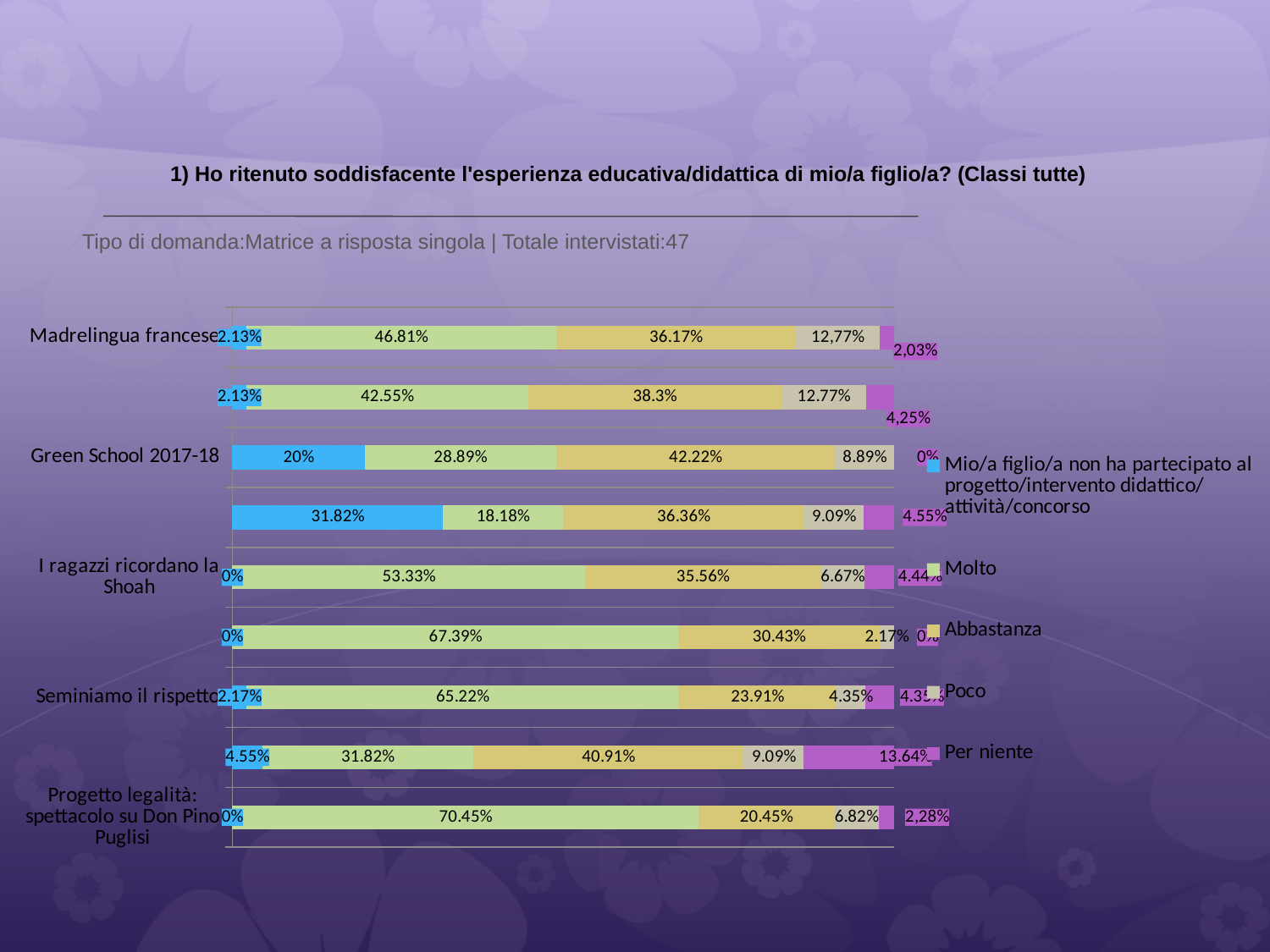
Which is larger, the 'Abbastanza' value for Madrelingua francese or for Seminiamo il rispetto? Madrelingua francese What is the 'Molto' value for Progetto legalità: spettacolo su Don Pino Puglisi? 70.45% How many series does the legend list? 5 What is the 'Molto' value for Madrelingua francese? 46.81% Which category has the highest 'Molto' value? Progetto legalità: spettacolo su Don Pino Puglisi What is the value for 'Mio/a figlio/a non ha partecipato al progetto/intervento didattico/attività/concorso' for Green School 2017-18? 20% What is the title of the chart? 1) Ho ritenuto soddisfacente l'esperienza educativa/didattica di mio/a figlio/a? (Classi tutte) What is the 'Per niente' value for I ragazzi ricordano la Shoah? 4.44% What is the 'Poco' value for Seminiamo il rispetto? 4.35% What is the difference between the 'Molto' values for Seminiamo il rispetto and I ragazzi ricordano la Shoah? 11.89% What type of chart is shown on the slide? stacked bar chart What is the 'Abbastanza' value for Green School 2017-18? 42.22%